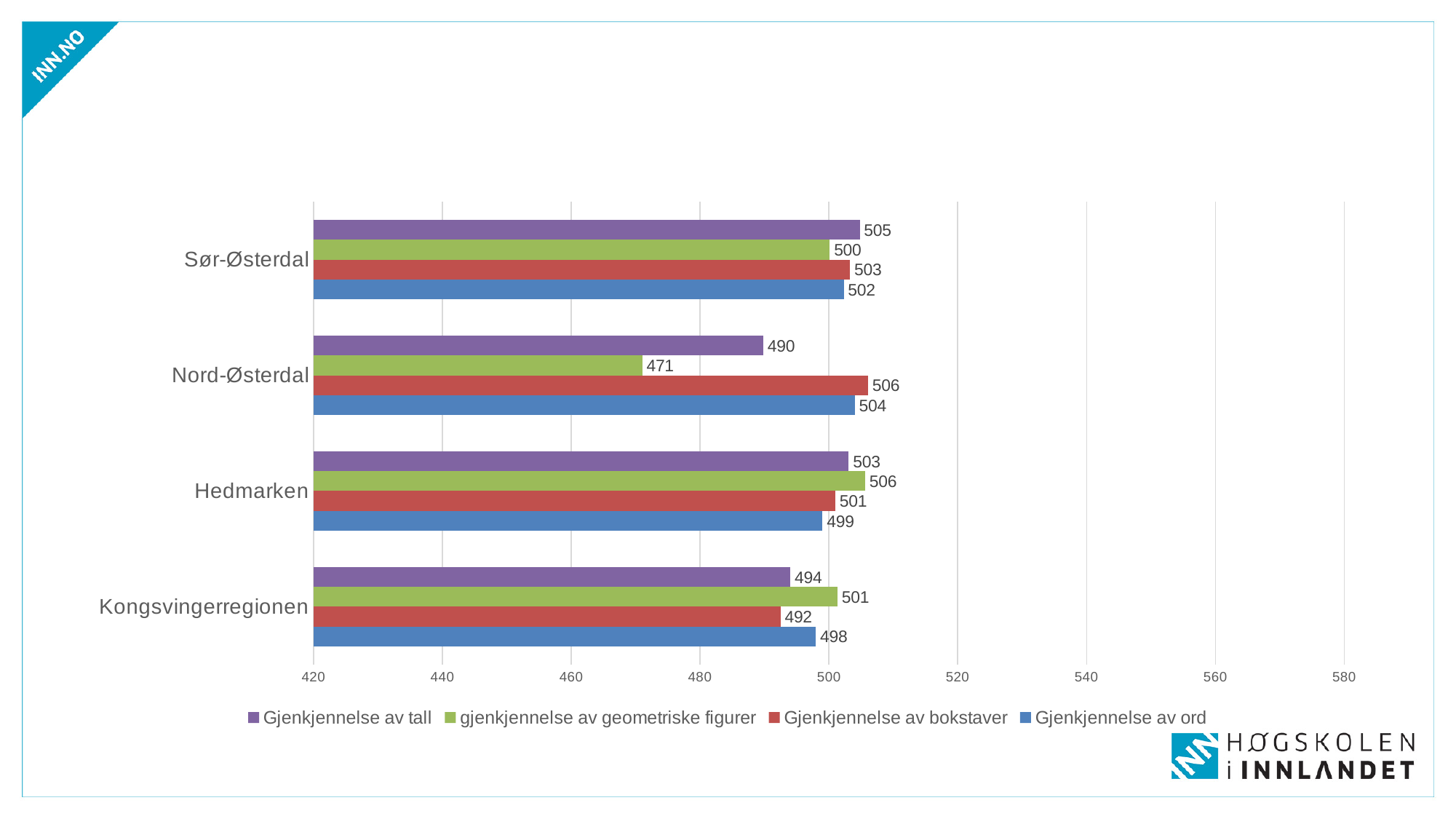
What is the value of Gjenkjennelse av tall for Sør-Østerdal? 505 What kind of chart is shown on the slide? Bar chart What is the value of gjenkjennelse av geometriske figurer for Nord-Østerdal? 471 Which region has the lowest value for gjenkjennelse av geometriske figurer? Nord-Østerdal How many regions are shown on the chart? 4 What is the value of Gjenkjennelse av ord for Kongsvingerregionen? 498 What is the difference between Gjenkjennelse av bokstaver and gjenkjennelse av geometriske figurer for Nord-Østerdal? 35 Which region has the highest value for Gjenkjennelse av tall? Sør-Østerdal Which is larger for Kongsvingerregionen: Gjenkjennelse av tall or gjenkjennelse av geometriske figurer? gjenkjennelse av geometriske figurer How many series does the legend list? 4 What is the value of Gjenkjennelse av bokstaver for Hedmarken? 501 Which colour represents Gjenkjennelse av ord in the chart? Blue